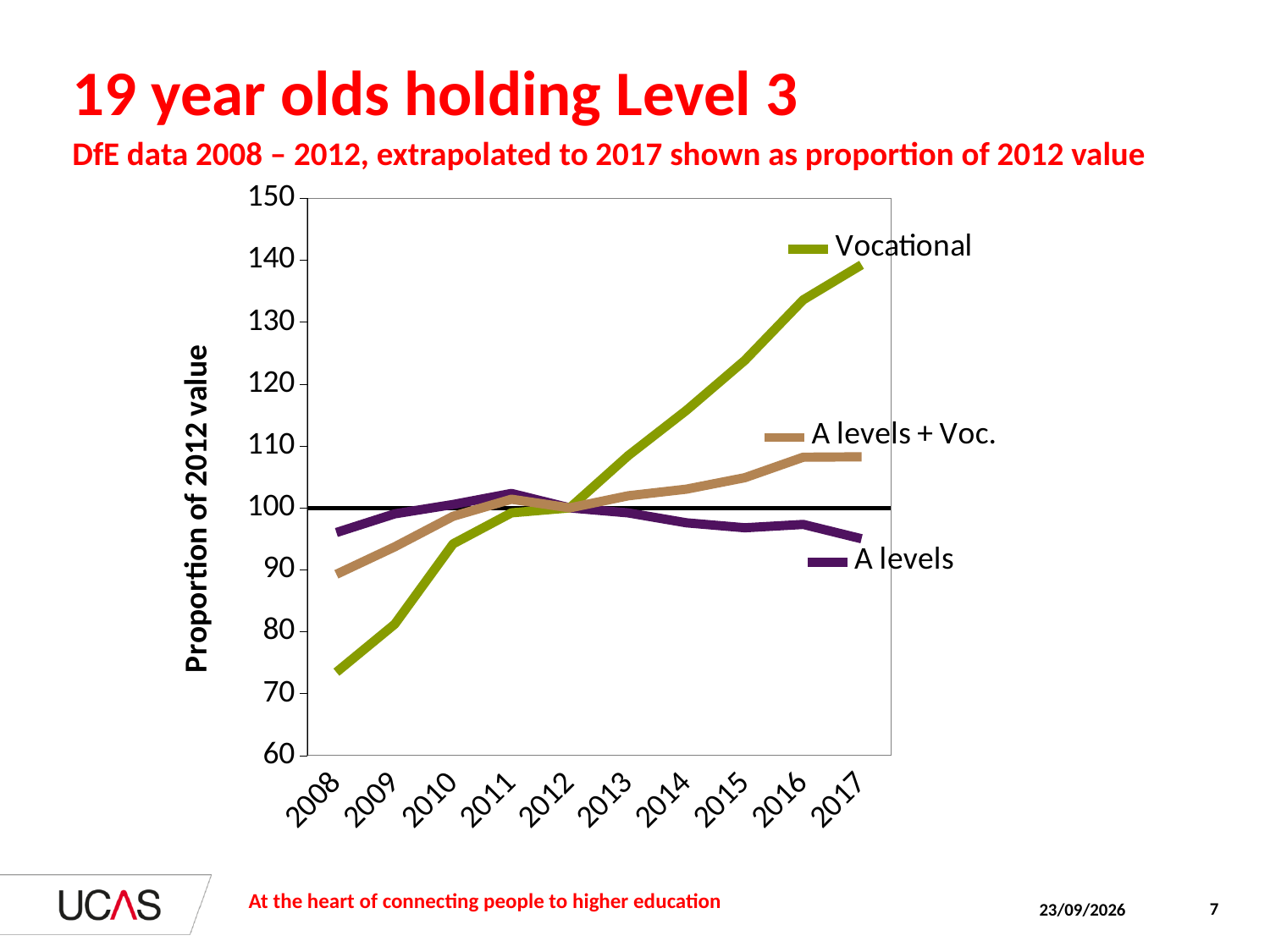
In 2008, which is larger: the value for A levels or the value for Vocational? A levels How many series does the chart's legend list? 3 What kind of chart is shown on the slide? Line chart Is the value for Vocational in 2017 greater or less than 130? greater Does the Vocational series rise or fall from 2012 to 2017? Rise Which series has the lowest value in 2008? Vocational Which series has the lowest value in 2017? A levels How many years are shown along the x axis of the chart? 10 Which series has the highest value in 2017? Vocational Is the value for A levels + Voc. in 2017 greater or less than 100? greater Is the value for A levels in 2017 greater or less than 100? less